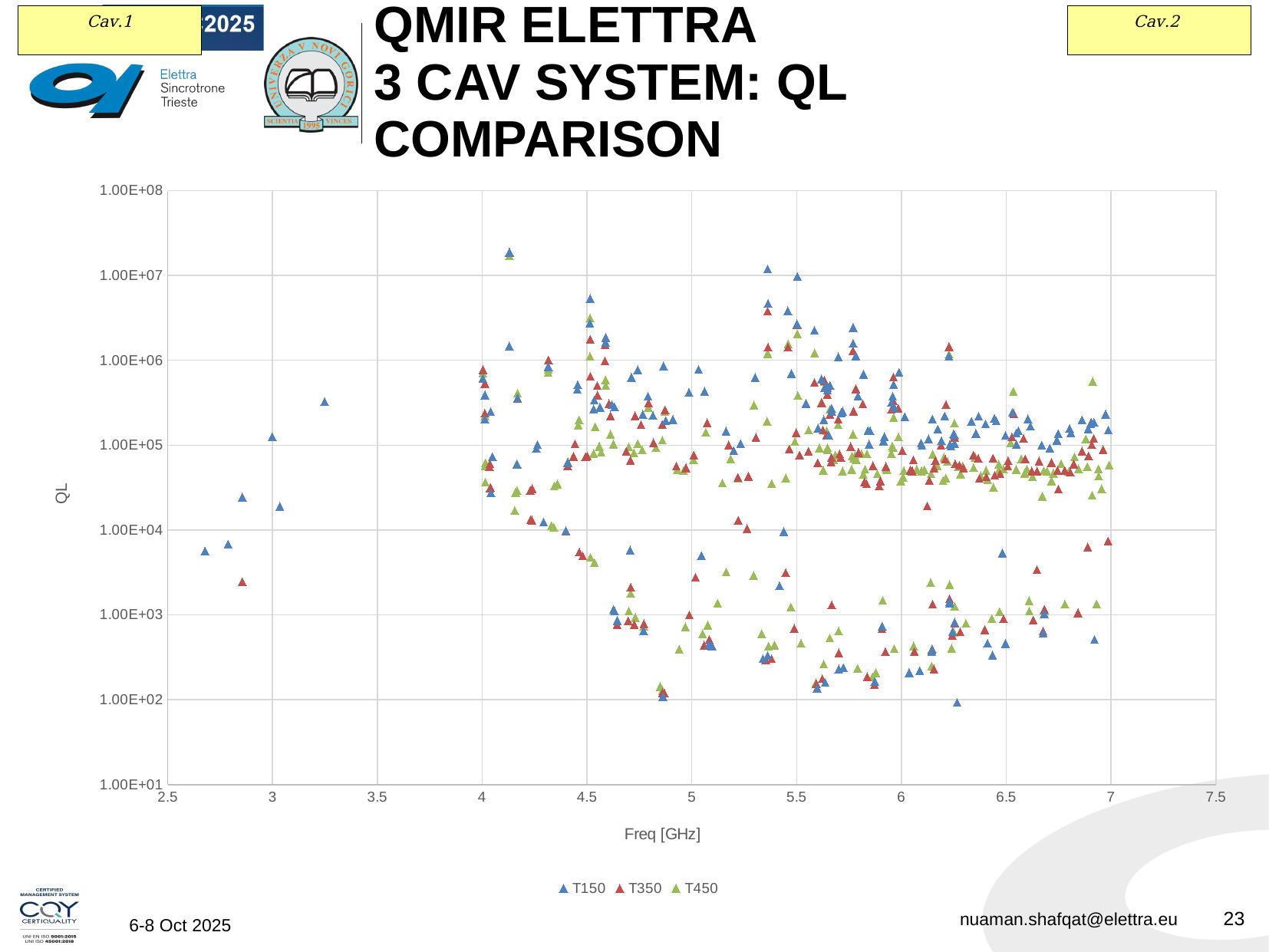
Is the QL value of the T150 point near 3.25 GHz greater or less than 1.00E+05? greater What kind of chart is shown on the slide? scatter chart Is the highest QL value plotted on the chart greater or less than 1.00E+07? greater Is the lowest QL value plotted on the chart greater or less than 1.00E+03? less What are the series names listed in the legend? T150, T350, T450 How many series does the legend list? 3 What is the label of the x axis? Freq [GHz]